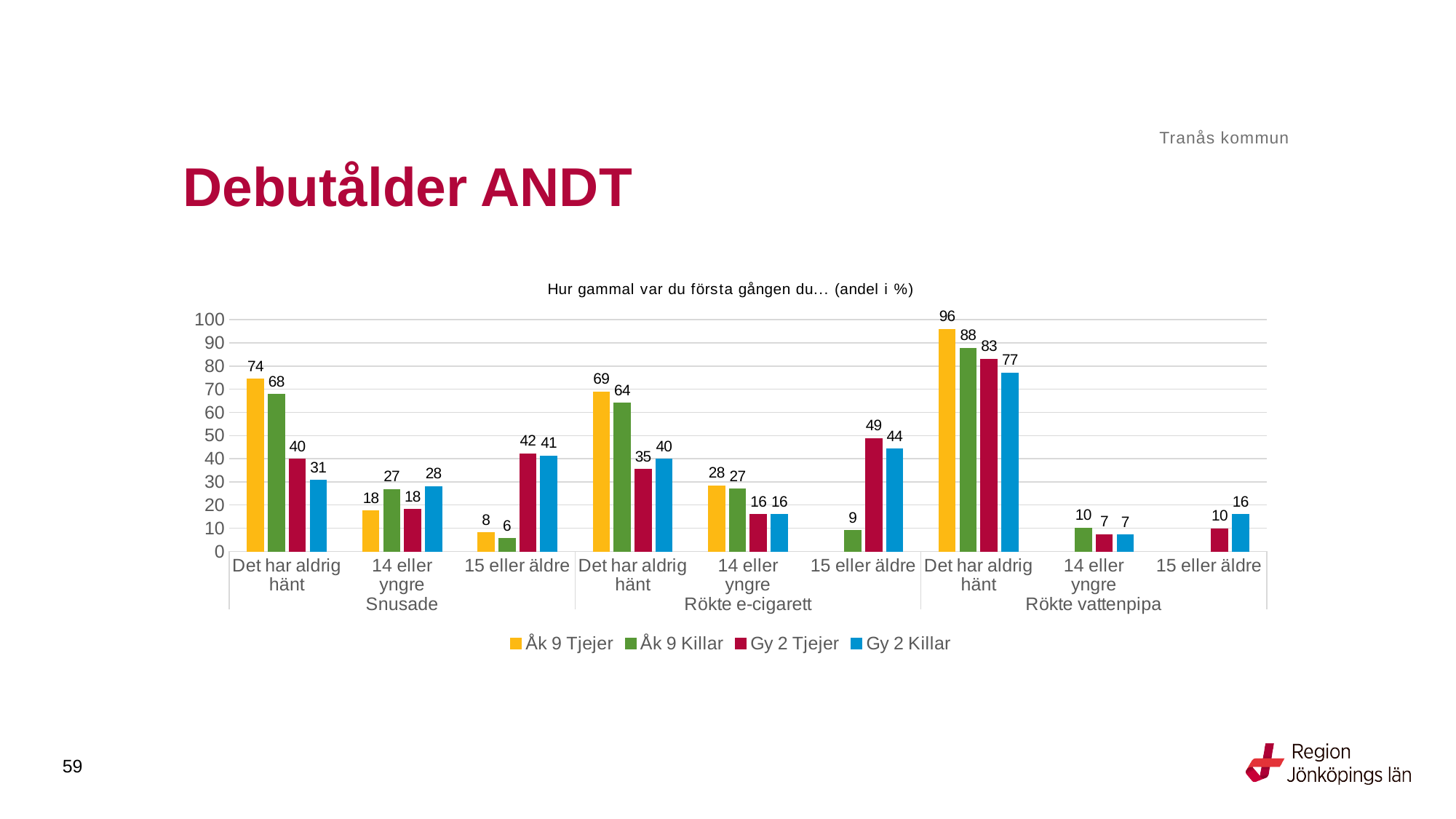
What is the value for Åk 9 Tjejer in the 'Det har aldrig hänt' category under Snusade? 74 Is the value for Åk 9 Killar in the 'Det har aldrig hänt' category under Rökte vattenpipa greater or less than 80? greater What is the value for Gy 2 Killar in the '15 eller äldre' category under Rökte vattenpipa? 16 What is the title of the chart? Hur gammal var du första gången du… (andel i %) Which series has the lowest value in the '15 eller äldre' category under Snusade? Åk 9 Killar Which series has the highest value in the 'Det har aldrig hänt' category under Rökte vattenpipa? Åk 9 Tjejer What kind of chart is shown on the slide? Bar chart What is the difference between Åk 9 Tjejer and Gy 2 Killar in the 'Det har aldrig hänt' category under Snusade? 43 How many series does the legend list? 4 What is the value for Gy 2 Killar in the 'Det har aldrig hänt' category under Rökte vattenpipa? 77 Which is larger: Gy 2 Tjejer or Gy 2 Killar in the 'Det har aldrig hänt' category under Rökte e-cigarett? Gy 2 Killar What is the value for Gy 2 Tjejer in the '15 eller äldre' category under Rökte e-cigarett? 49